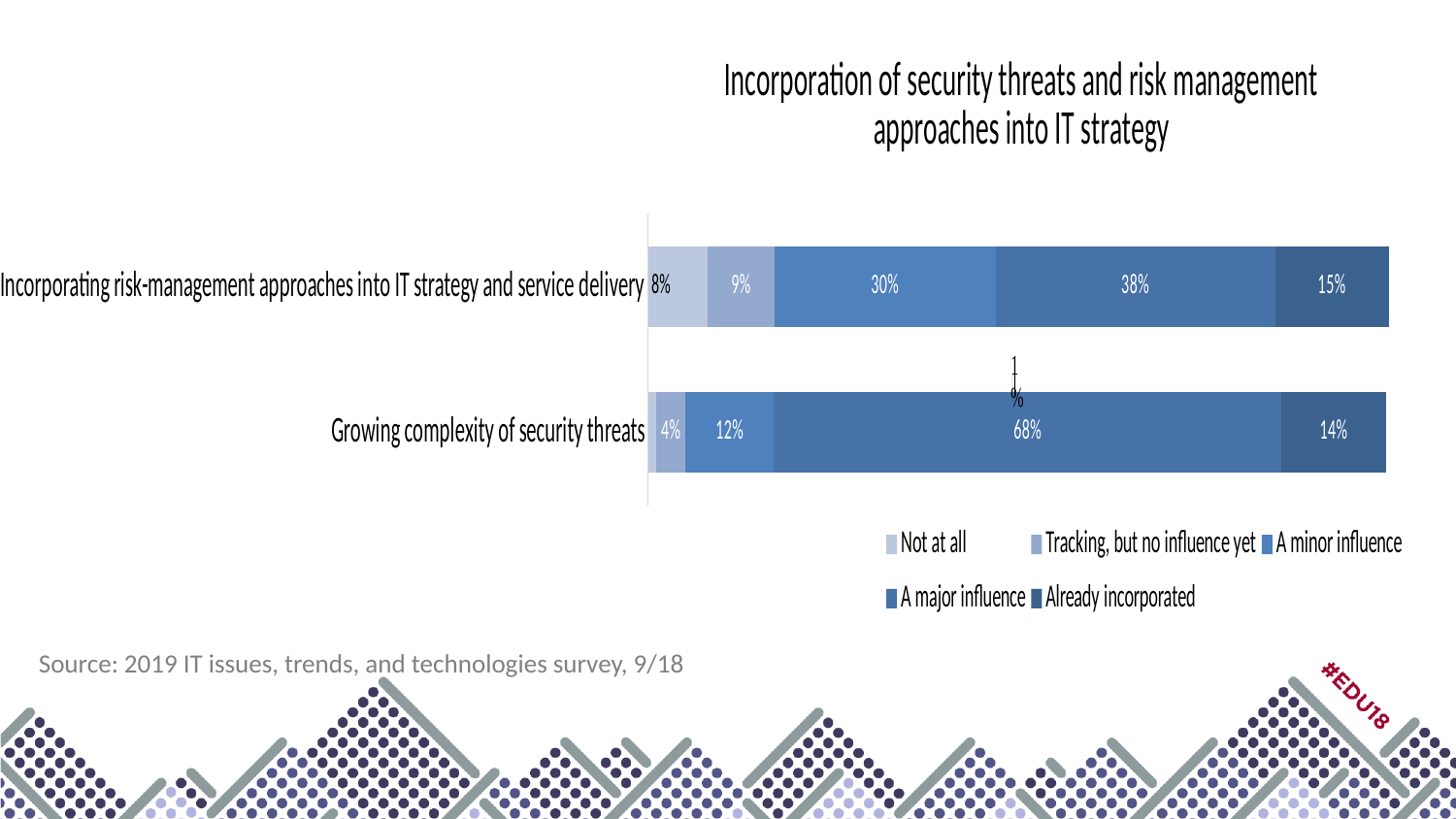
What is the 'Not at all' value for 'Incorporating risk-management approaches into IT strategy and service delivery'? 8% Which category has the larger 'A major influence' share: 'Growing complexity of security threats' or 'Incorporating risk-management approaches into IT strategy and service delivery'? Growing complexity of security threats What percentage of respondents said 'A major influence' for 'Growing complexity of security threats'? 68% What is the 'A minor influence' value for 'Growing complexity of security threats'? 12% Which segment is the largest in the 'Incorporating risk-management approaches into IT strategy and service delivery' bar? A major influence How many categories (bars) are plotted in the chart? 2 What percentage of respondents said 'A major influence' for 'Incorporating risk-management approaches into IT strategy and service delivery'? 38% What kind of chart is shown on the slide? Stacked bar chart What is the difference between the 'A major influence' values for 'Growing complexity of security threats' (68%) and 'Incorporating risk-management approaches into IT strategy and service delivery' (38%)? 30% What is the title of the chart? Incorporation of security threats and risk management approaches into IT strategy What is the 'Already incorporated' value for 'Incorporating risk-management approaches into IT strategy and service delivery'? 15% How many series does the legend list? 5